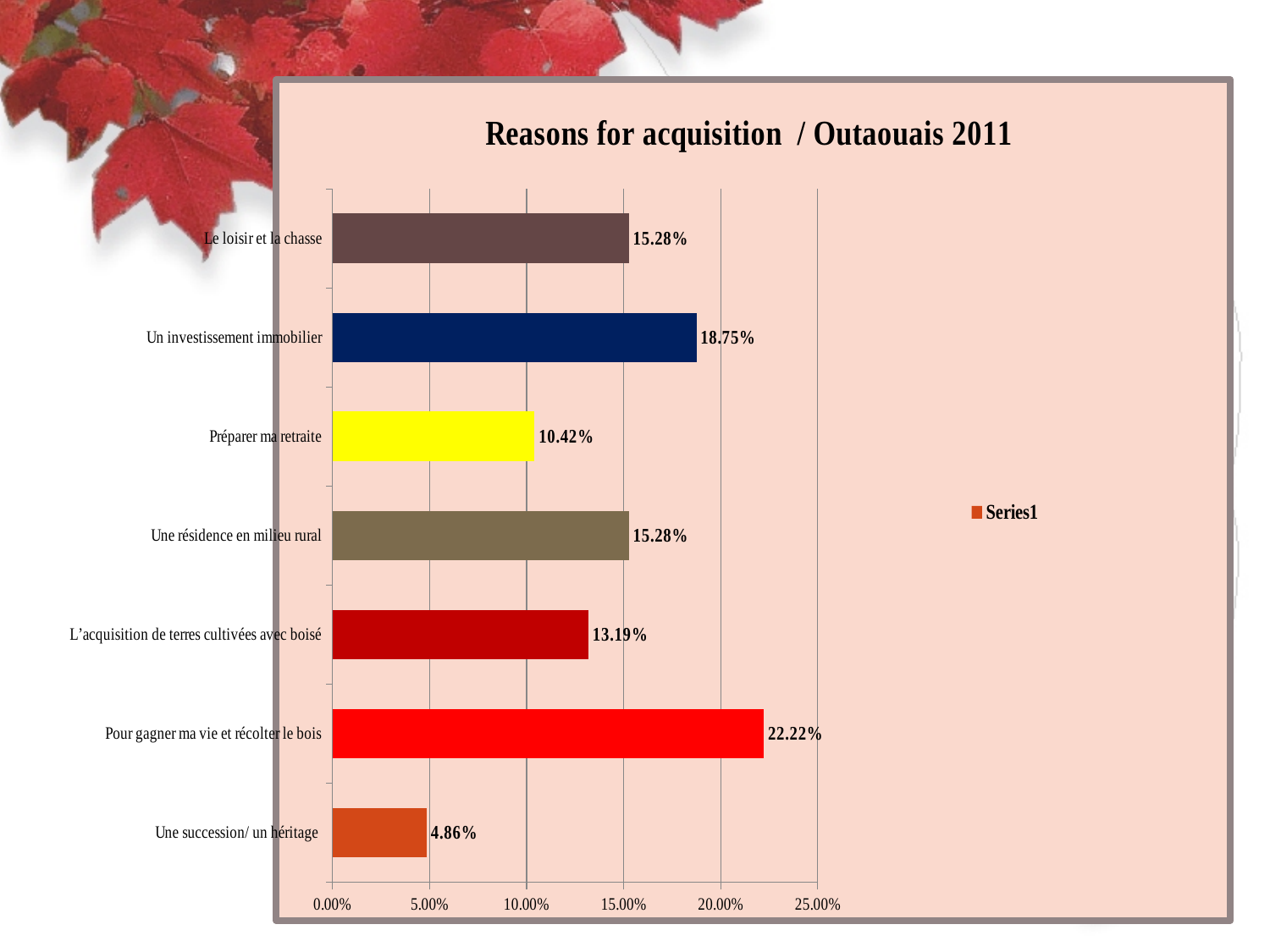
What kind of chart is shown on the slide? bar chart What is the value for "Une succession/ un héritage"? 4.86% What is the value for "Préparer ma retraite"? 10.42% What is the title of the chart? Reasons for acquisition / Outaouais 2011 What is the value for "Pour gagner ma vie et récolter le bois"? 22.22% What is the value for "Un investissement immobilier"? 18.75% Which is larger: the value for "L'acquisition de terres cultivées avec boisé" or the value for "Préparer ma retraite"? L'acquisition de terres cultivées avec boisé Which category has the lowest value? Une succession/ un héritage What is the difference between the values for "Pour gagner ma vie et récolter le bois" and "Un investissement immobilier"? 3.47% Which category has the highest value? Pour gagner ma vie et récolter le bois How many categories are shown in the chart? 7 Is the value for "Le loisir et la chasse" greater or less than 20.00%? less